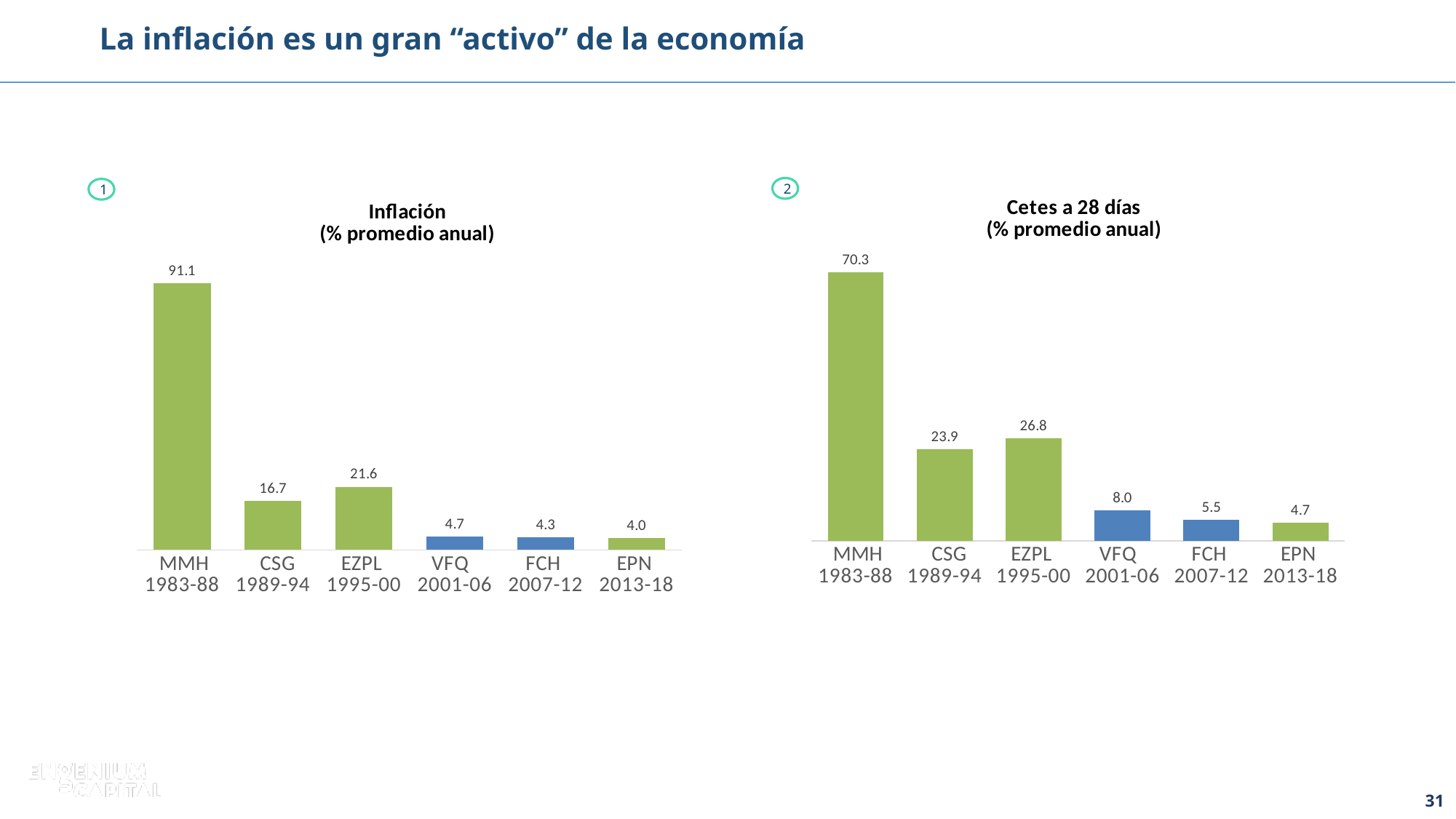
What kind of chart is the 'Cetes a 28 días (% promedio anual)' chart? Bar chart In the 'Inflación (% promedio anual)' chart, which category has the lowest value? EPN 2013-18 In the 'Cetes a 28 días (% promedio anual)' chart, which is larger, the value for CSG 1989-94 or EZPL 1995-00? EZPL 1995-00 In the 'Cetes a 28 días (% promedio anual)' chart, what is the difference between the values for MMH 1983-88 and CSG 1989-94? 46.4 In the 'Cetes a 28 días (% promedio anual)' chart, what is the value for FCH 2007-12? 5.5 In the 'Inflación (% promedio anual)' chart, how many categories are shown on the x axis? 6 In the 'Inflación (% promedio anual)' chart, what is the value for MMH 1983-88? 91.1 In the 'Inflación (% promedio anual)' chart, which is larger, the value for VFQ 2001-06 or FCH 2007-12? VFQ 2001-06 In the 'Inflación (% promedio anual)' chart, what is the difference between the values for EZPL 1995-00 and CSG 1989-94? 4.9 In the 'Inflación (% promedio anual)' chart, which bars are coloured blue rather than green? VFQ 2001-06 and FCH 2007-12 In the 'Cetes a 28 días (% promedio anual)' chart, which category has the highest value? MMH 1983-88 In the 'Cetes a 28 días (% promedio anual)' chart, what is the value for EZPL 1995-00? 26.8